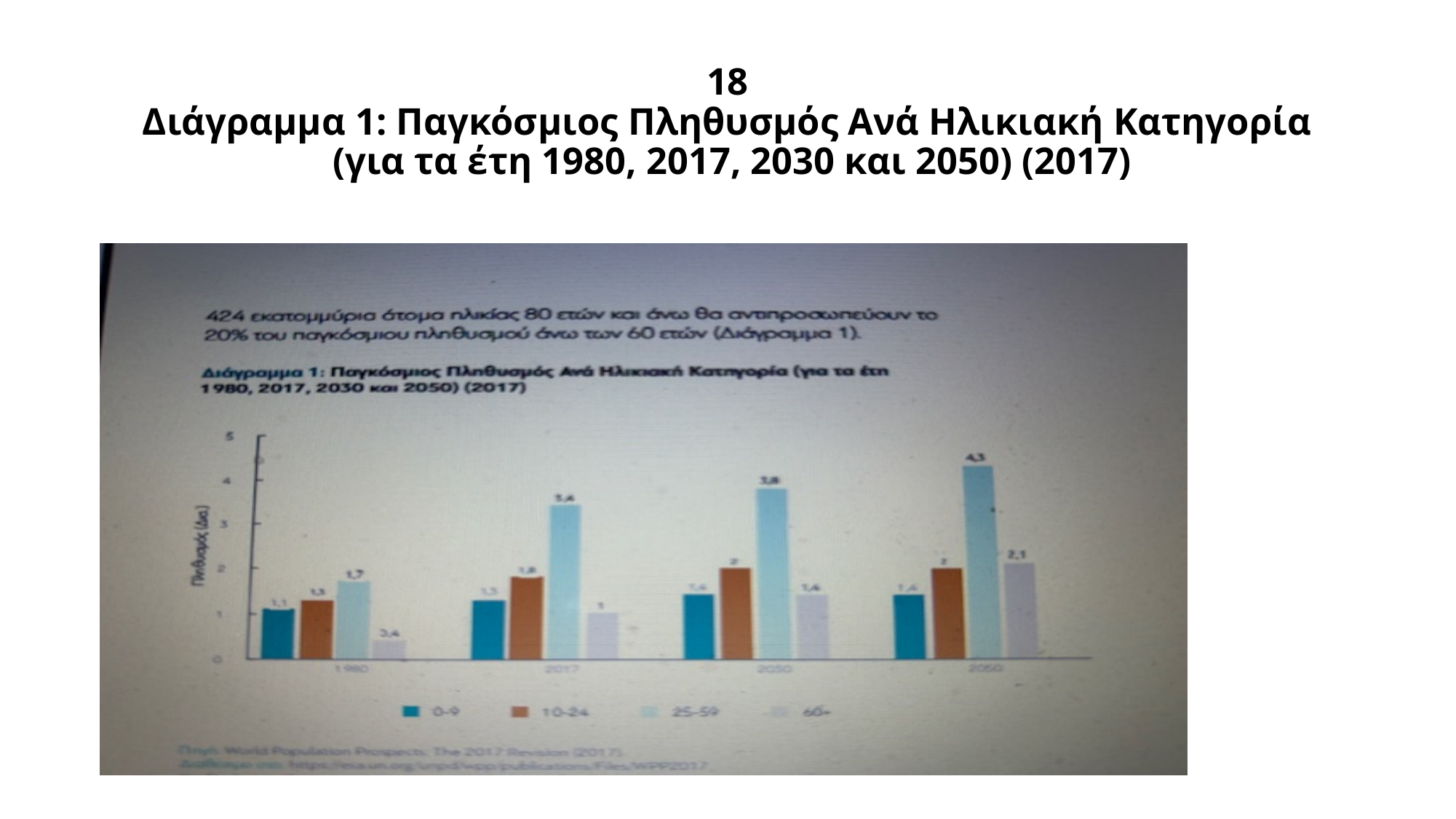
How many series does the legend list? 4 In which year is the 25-59 bar the highest? 2050 Which age group has the lowest bar in the 1980 group? 60+ What is the value for the 25-59 age group in 2030? 3,8 What is the difference between the 25-59 values for 2050 and 2030? 0,5 In 2050, which is larger: the 60+ bar or the 0-9 bar? 60+ What kind of chart is shown on the slide? Bar chart What is the value for the 60+ age group in 2050? 2,1 Do the values for the 25-59 age group rise or fall from 1980 to 2050? Rise What is the value for the 25-59 age group in 2050? 4,3 Is the value for the 0-9 age group in 1980 greater or less than 2? less How many year groups are shown on the x axis? 4